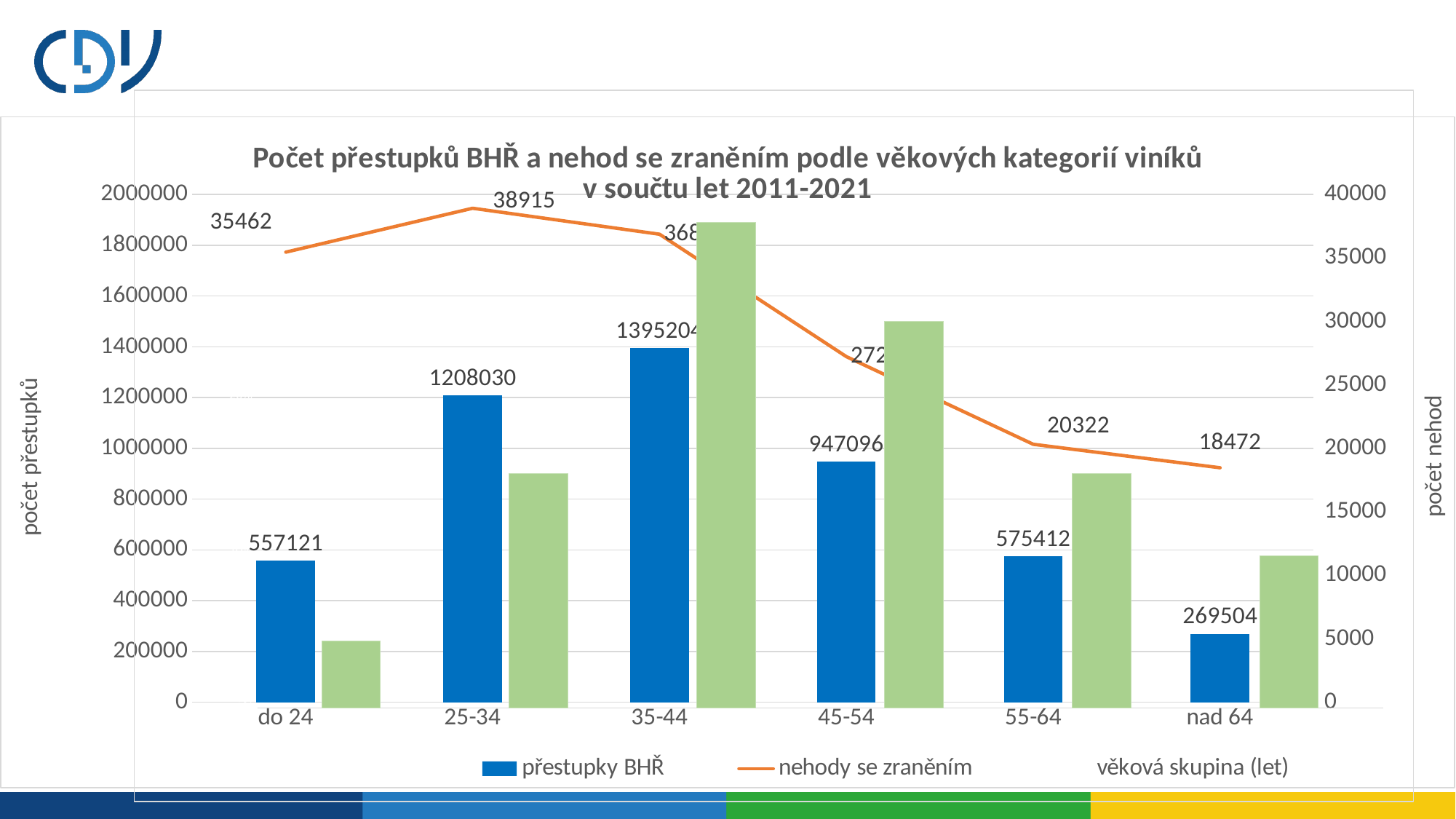
What is the value of přestupky BHŘ for the nad 64 age group? 269504 Which has more přestupky BHŘ, the do 24 group or the 55-64 group? 55-64 Which age group has the highest value of nehody se zraněním? 25-34 What is the value of nehody se zraněním for the nad 64 age group? 18472 Which age group has the highest value of přestupky BHŘ? 35-44 Which age group has the lowest value of přestupky BHŘ? nad 64 Do the values of nehody se zraněním rise or fall from the 25-34 group to the nad 64 group? fall How many age groups are shown on the x axis? 6 What is the difference between přestupky BHŘ for 25-34 and for 45-54? 260934 What is the value of nehody se zraněním for the 25-34 age group? 38915 What is the value of přestupky BHŘ for the 35-44 age group? 1395204 What is the value of přestupky BHŘ for the 25-34 age group? 1208030